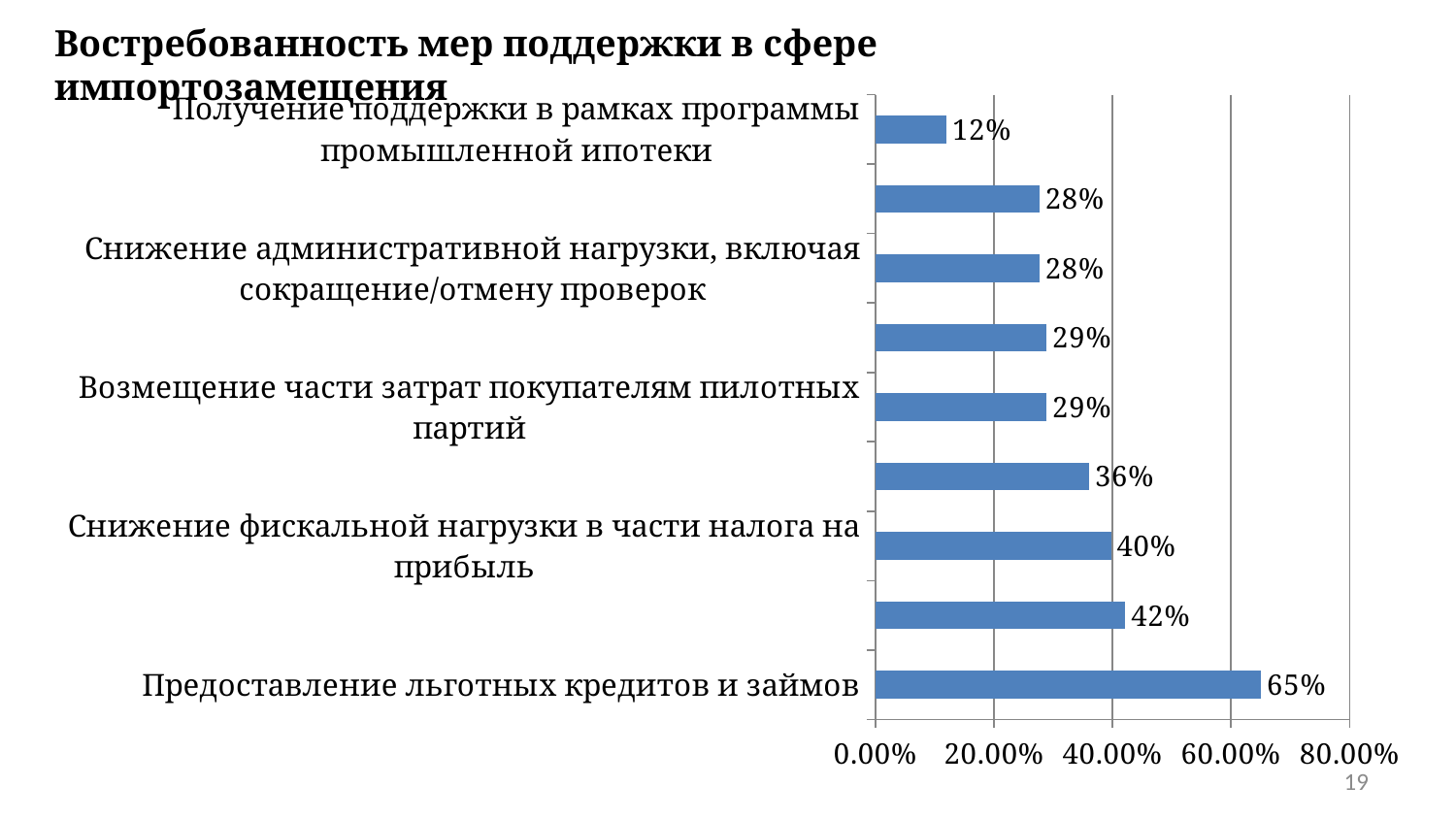
What is the value for "Снижение административной нагрузки, включая сокращение/отмену проверок"? 28% What is the value for "Получение поддержки в рамках программы промышленной ипотеки"? 12% Which category has the highest value? Предоставление льготных кредитов и займов What is the difference between the value for "Предоставление льготных кредитов и займов" and the value for "Получение поддержки в рамках программы промышленной ипотеки"? 53 percentage points What type of chart is shown on the slide? bar chart What is the value for "Возмещение части затрат покупателям пилотных партий"? 29% What is the value for "Предоставление льготных кредитов и займов"? 65% Which is larger: the value for "Снижение фискальной нагрузки в части налога на прибыль" or the value for "Возмещение части затрат покупателям пилотных партий"? Снижение фискальной нагрузки в части налога на прибыль How many bars are plotted in the chart? 9 What is the value for "Снижение фискальной нагрузки в части налога на прибыль"? 40% Which category has the lowest value? Получение поддержки в рамках программы промышленной ипотеки What is the title of the slide containing the chart? Востребованность мер поддержки в сфере импортозамещения